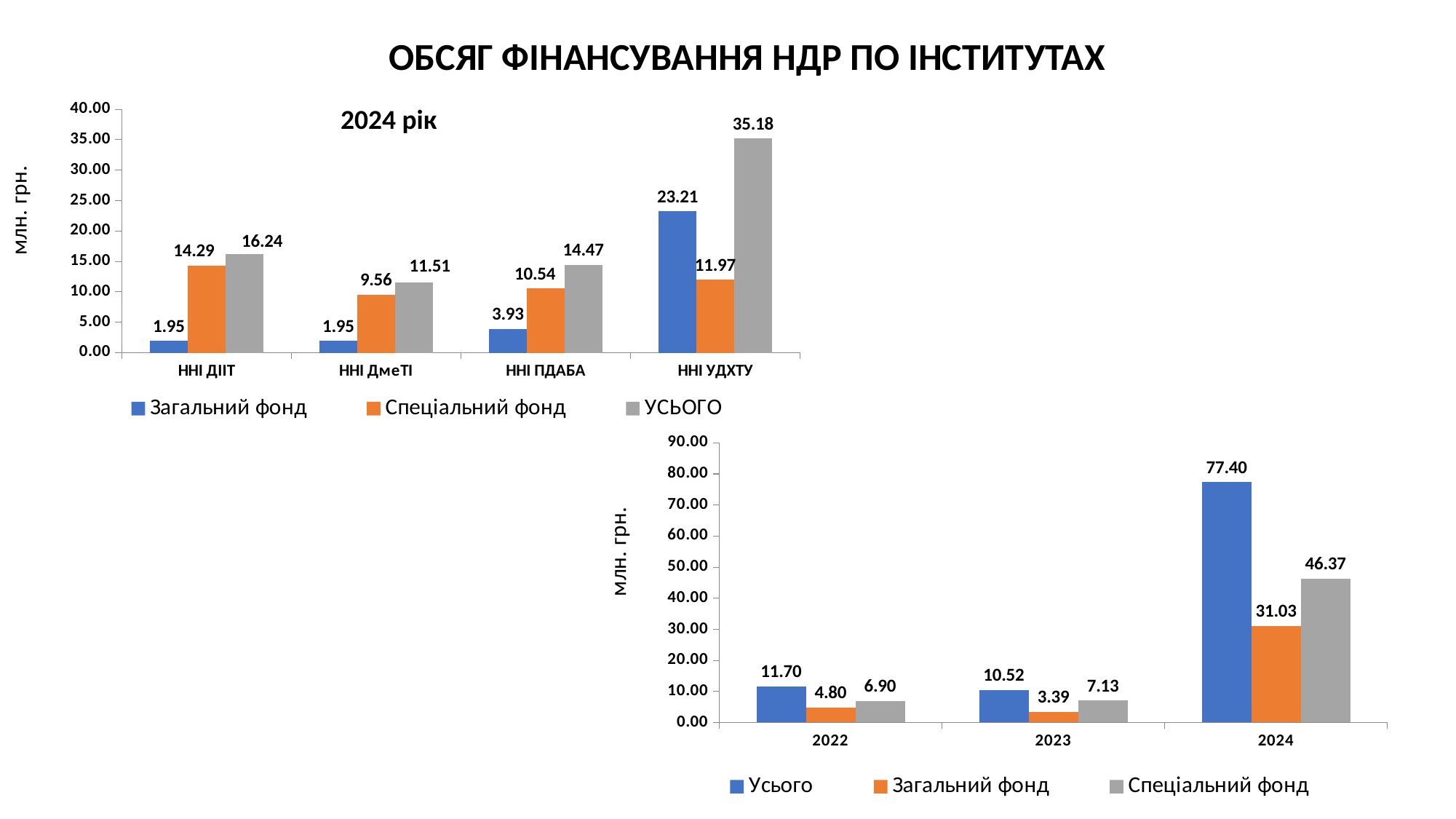
In the top-left chart (2024 рік), which institute has the highest Загальний фонд value? ННІ УДХТУ In the top-left chart (2024 рік), which institute has the lowest УСЬОГО value? ННІ ДмеТІ In the bottom-right chart, what is the Загальний фонд value for 2023? 3.39 What type of chart is the bottom-right chart? Bar chart In the bottom-right chart, which is larger: Спеціальний фонд in 2022 or in 2023? 2023 In the top-left chart (2024 рік), what is the difference between the УСЬОГО values for ННІ УДХТУ and ННІ ДІІТ? 18.94 In the top-left chart (2024 рік), how many institutes are shown on the x axis? 4 In the top-left chart (2024 рік), how many series does the legend list? 3 In the bottom-right chart, what is the Усього value for 2024? 77.40 In the top-left chart (2024 рік), what is the value of Спеціальний фонд for ННІ ДІІТ? 14.29 In the top-left chart (2024 рік), what is the УСЬОГО value for ННІ УДХТУ? 35.18 In the bottom-right chart, what is the difference between the Усього values for 2024 and 2023? 66.88